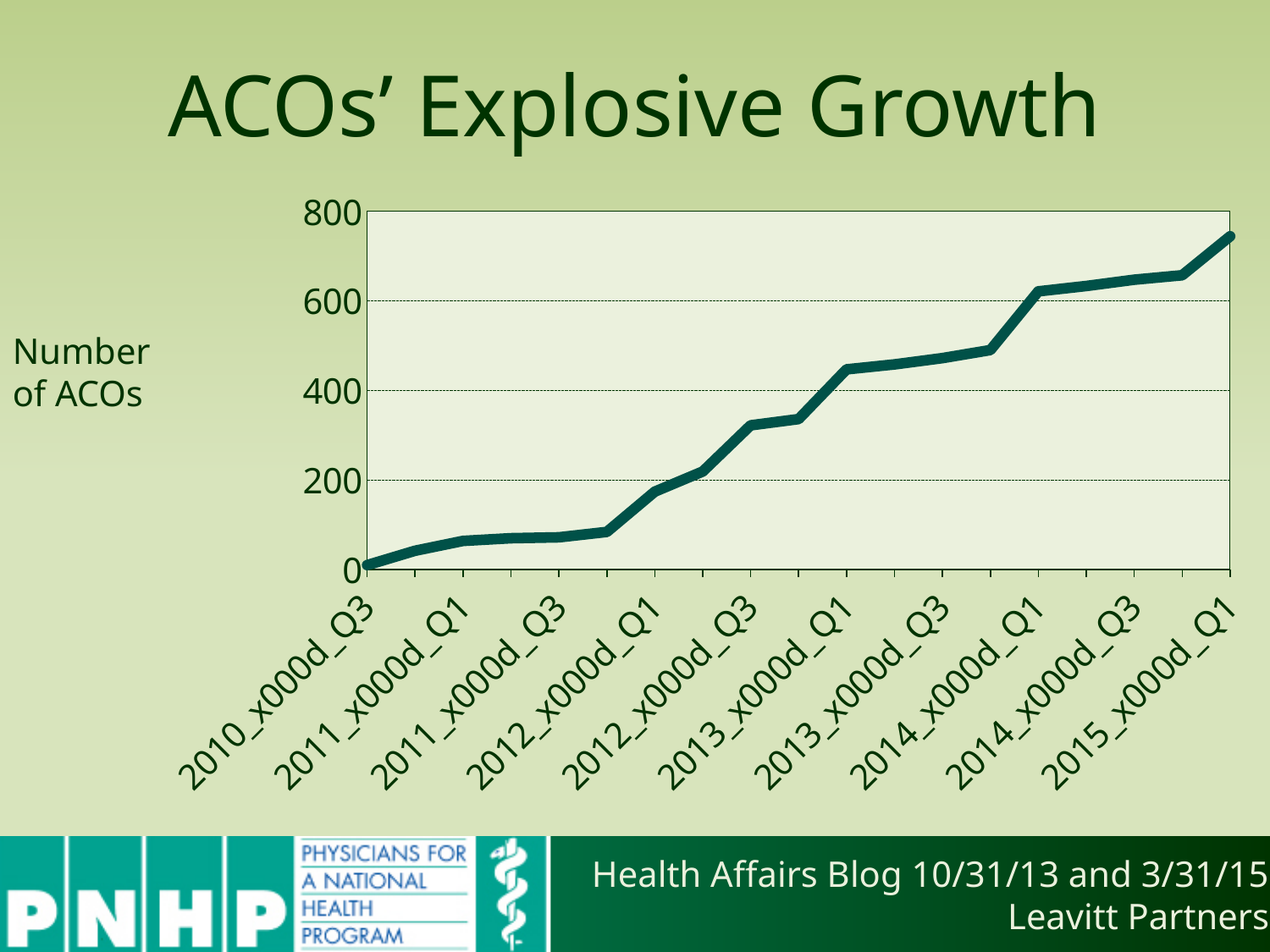
Which is larger, the value for 2015_x000d_Q1 or the value for 2013_x000d_Q1? 2015_x000d_Q1 Is the value for 2015_x000d_Q1 greater or less than 600? greater What quantity does the y axis of the chart represent? Number of ACOs Which category has the highest value on the chart? 2015_x000d_Q1 Is the value for 2012_x000d_Q1 greater or less than 400? less Is the value for 2010_x000d_Q3 greater or less than 200? less Do the values rise or fall along the x axis from 2010_x000d_Q3 to 2015_x000d_Q1? rise What kind of chart is shown on the slide? line chart Which category has the lowest value on the chart? 2010_x000d_Q3 What is the title of the chart on the slide? ACOs' Explosive Growth